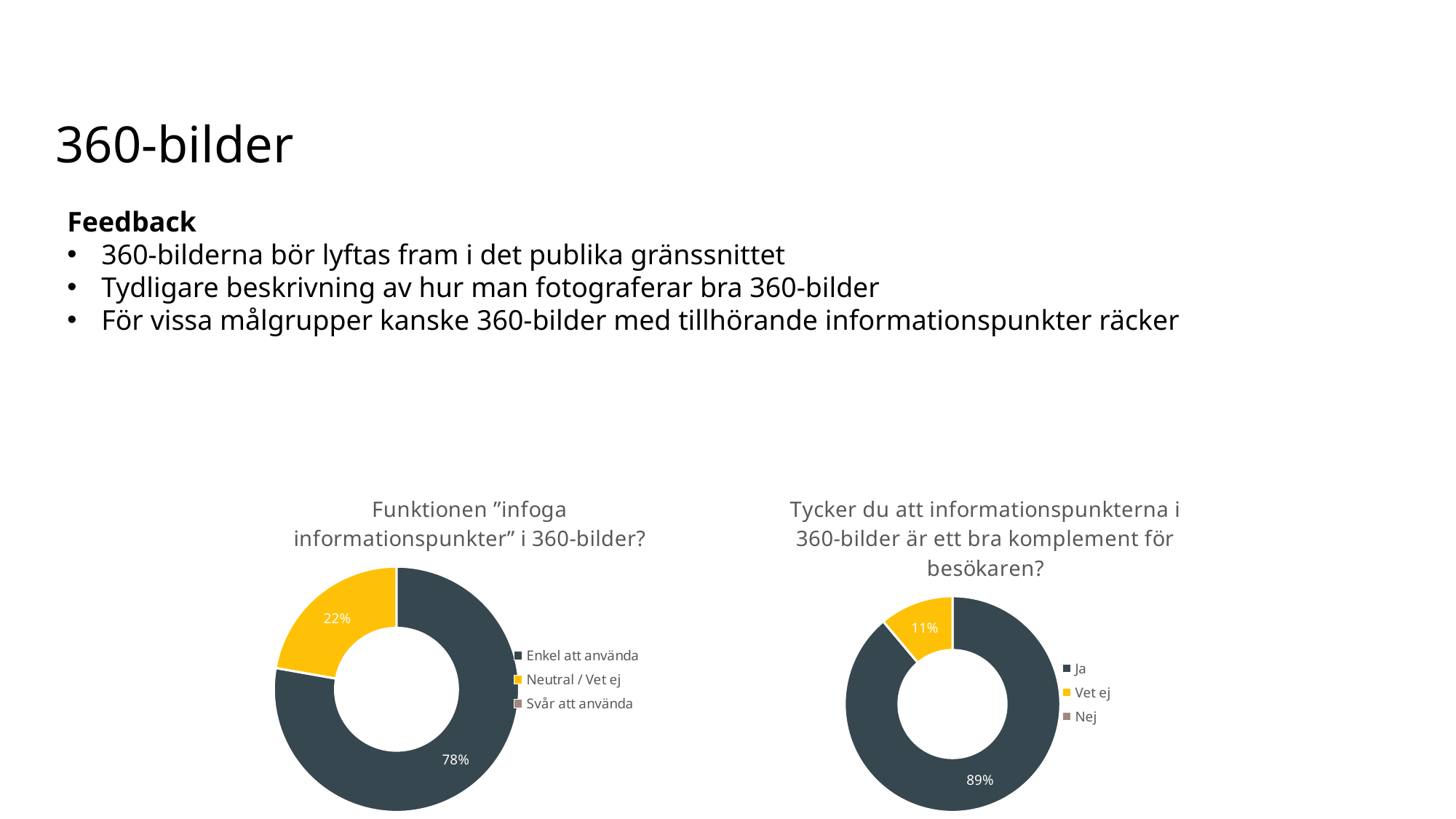
How many categories does the legend of the left chart, 'Funktionen "infoga informationspunkter" i 360-bilder?', list? 3 In the left chart, 'Funktionen "infoga informationspunkter" i 360-bilder?', what share of respondents answered 'Neutral / Vet ej'? 22% In the right chart, 'Tycker du att informationspunkterna i 360-bilder är ett bra komplement för besökaren?', what is the difference in percentage points between 'Ja' and 'Vet ej'? 78 percentage points Which is larger: the 'Enkel att använda' share in the left chart or the 'Ja' share in the right chart? Ja (right chart) In the right chart, 'Tycker du att informationspunkterna i 360-bilder är ett bra komplement för besökaren?', what share of respondents answered 'Ja'? 89% In the left chart, 'Funktionen "infoga informationspunkter" i 360-bilder?', what is the difference in percentage points between 'Enkel att använda' and 'Neutral / Vet ej'? 56 percentage points In the left chart, 'Funktionen "infoga informationspunkter" i 360-bilder?', what share of respondents answered 'Enkel att använda'? 78% What type of chart is used for 'Tycker du att informationspunkterna i 360-bilder är ett bra komplement för besökaren?'? Pie (doughnut) chart In the left chart, 'Funktionen "infoga informationspunkter" i 360-bilder?', which category has the largest share? Enkel att använda In the right chart, 'Tycker du att informationspunkterna i 360-bilder är ett bra komplement för besökaren?', what colour is the 'Vet ej' slice? Yellow In the right chart, 'Tycker du att informationspunkterna i 360-bilder är ett bra komplement för besökaren?', what share of respondents answered 'Vet ej'? 11% In the right chart, 'Tycker du att informationspunkterna i 360-bilder är ett bra komplement för besökaren?', which category has the largest share? Ja